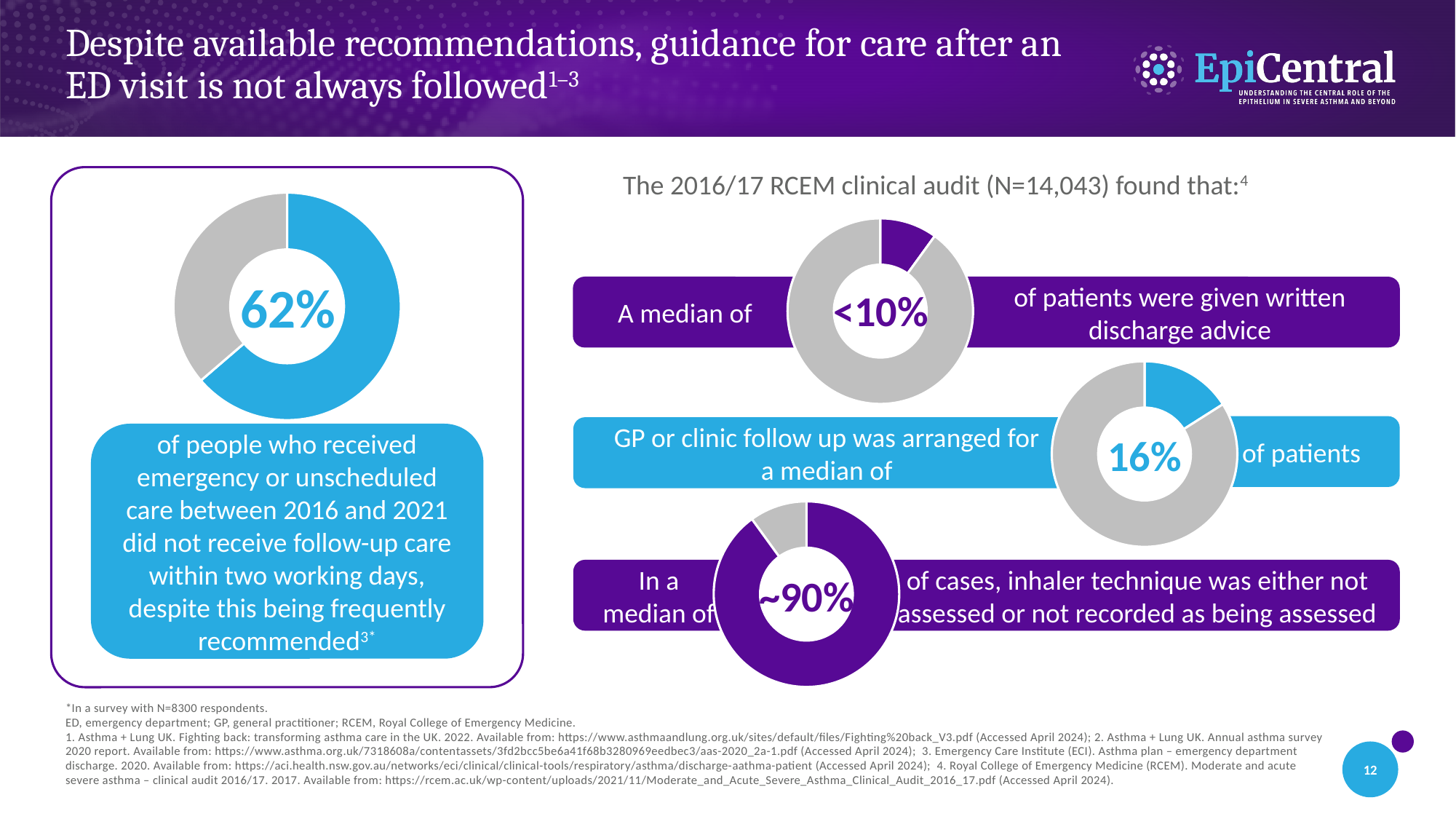
How many donut charts are shown on the slide? 4 In the left chart, what percentage of people who received emergency or unscheduled care between 2016 and 2021 did not receive follow-up care within two working days? 62% In the top-right donut chart, what median percentage of patients were given written discharge advice? <10% Which is larger: the 62% value in the left chart or the 16% value in the GP or clinic follow up chart? 62% (left chart) What kind of chart is used to show the 62% figure on the left of the slide? Donut (pie) chart Of the four donut charts, which one shows the largest highlighted share? The inhaler technique chart (~90%) In the middle-right donut chart, GP or clinic follow up was arranged for a median of what percentage of patients? 16% What colour is the highlighted segment in the top-right donut chart showing <10%? Purple Of the four donut charts, which one shows the smallest highlighted share? The written discharge advice chart (<10%) What is the difference in percentage points between the 62% value in the left chart and the 16% value in the GP or clinic follow up chart? 46 percentage points In the bottom-right donut chart, in what median percentage of cases was inhaler technique either not assessed or not recorded as being assessed? ~90%